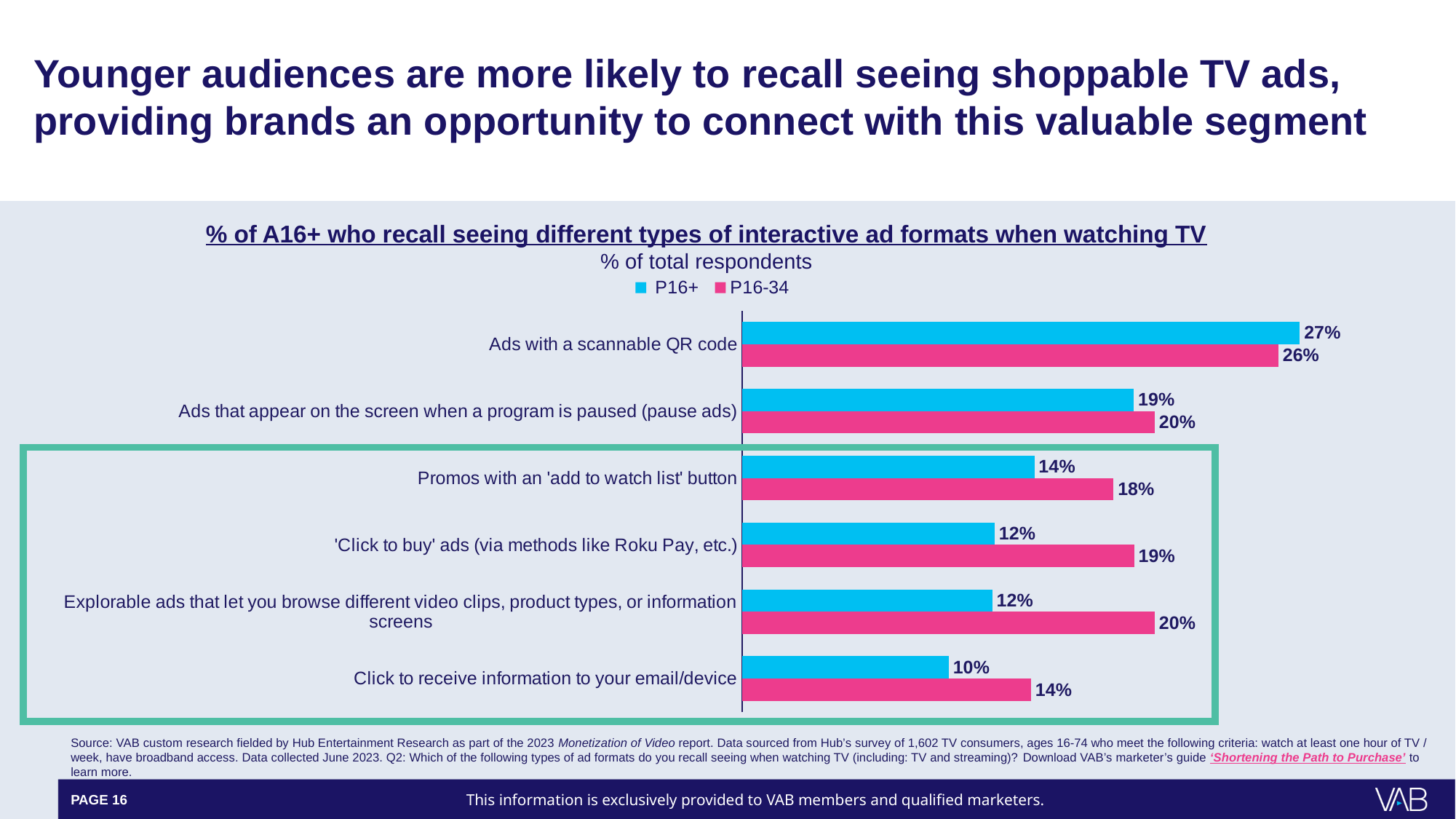
For pause ads, which group has the higher recall, P16+ or P16-34? P16-34 For ads with a scannable QR code, which group has the higher recall, P16+ or P16-34? P16+ What is the difference between the P16-34 and P16+ values for 'Click to buy' ads? 7% Which ad format has the highest recall among P16+? Ads with a scannable QR code What percentage of P16-34 recall seeing 'Click to buy' ads (via methods like Roku Pay, etc.)? 19% How many ad format categories are shown in the chart? 6 Which ad format has the lowest recall among P16-34? Click to receive information to your email/device What is the difference between the P16-34 and P16+ values for explorable ads that let you browse different video clips, product types, or information screens? 8% What percentage of P16+ recall seeing ads with a scannable QR code? 27% What is the P16-34 value for 'Click to receive information to your email/device'? 14% What type of chart is shown on the slide? Bar chart How many series does the legend list? 2